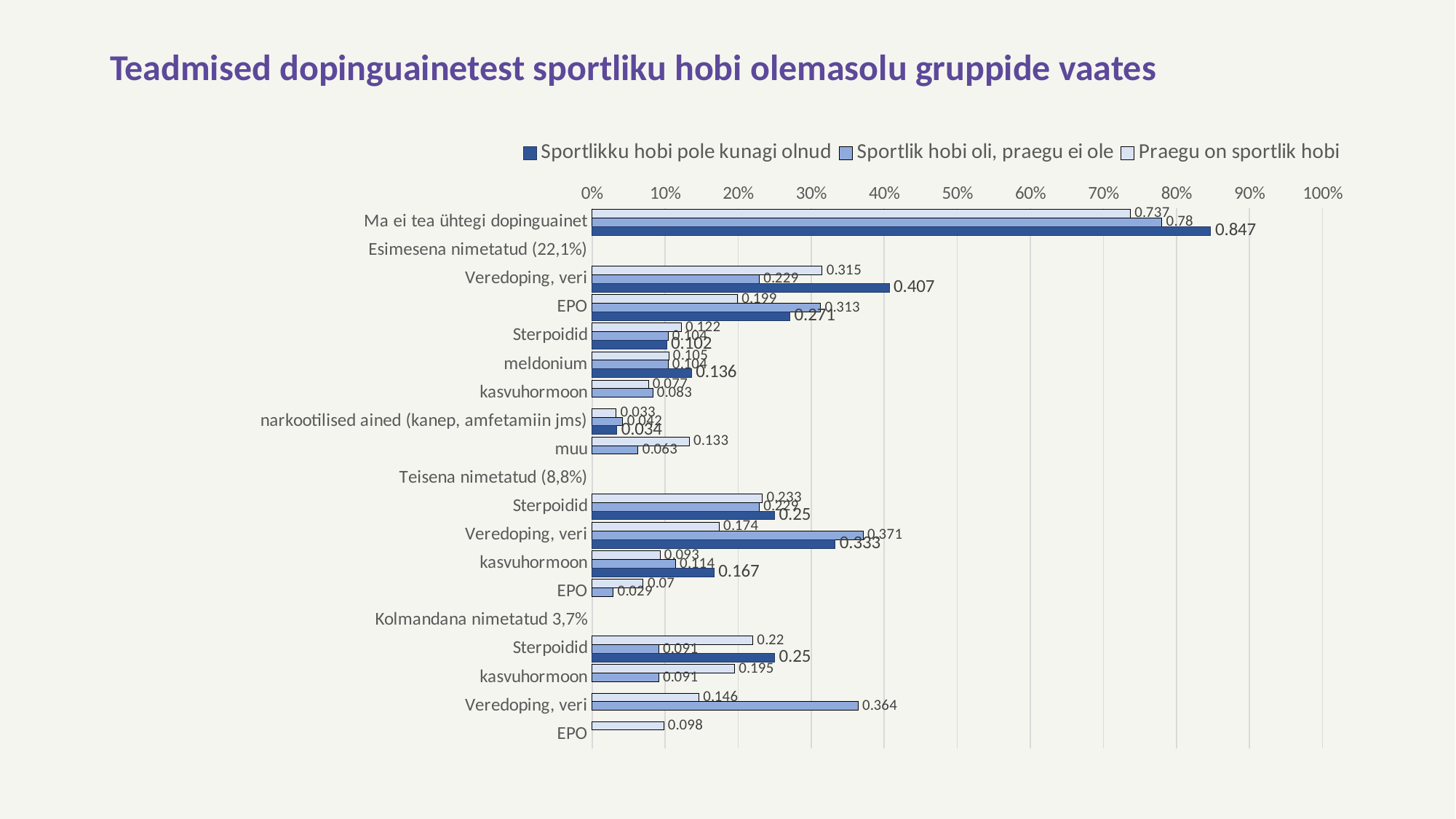
What is the value for 'Ma ei tea ühtegi dopinguainet' in the 'Praegu on sportlik hobi' series? 0.737 How many series does the legend list? 3 What is the value for 'Ma ei tea ühtegi dopinguainet' in the 'Sportlikku hobi pole kunagi olnud' series? 0.847 What is the title of the slide? Teadmised dopinguainetest sportliku hobi olemasolu gruppide vaates What is the difference between the 'Sportlikku hobi pole kunagi olnud' and 'Praegu on sportlik hobi' values for 'Ma ei tea ühtegi dopinguainet'? 0.11 Under 'Esimesena nimetatud', which is larger for 'EPO': the 'Sportlik hobi oli, praegu ei ole' value or the 'Sportlikku hobi pole kunagi olnud' value? Sportlik hobi oli, praegu ei ole Is the value for 'Ma ei tea ühtegi dopinguainet' in the 'Sportlik hobi oli, praegu ei ole' series greater or less than 70%? greater Which series has the highest value for 'Ma ei tea ühtegi dopinguainet'? Sportlikku hobi pole kunagi olnud Under 'Kolmandana nimetatud', what is the value for 'Veredoping, veri' in the 'Sportlik hobi oli, praegu ei ole' series? 0.364 What kind of chart is shown on the slide? bar chart Under 'Kolmandana nimetatud', what is the value for 'EPO' in the 'Praegu on sportlik hobi' series? 0.098 Under 'Esimesena nimetatud', what is the value for 'Veredoping, veri' in the 'Sportlikku hobi pole kunagi olnud' series? 0.407